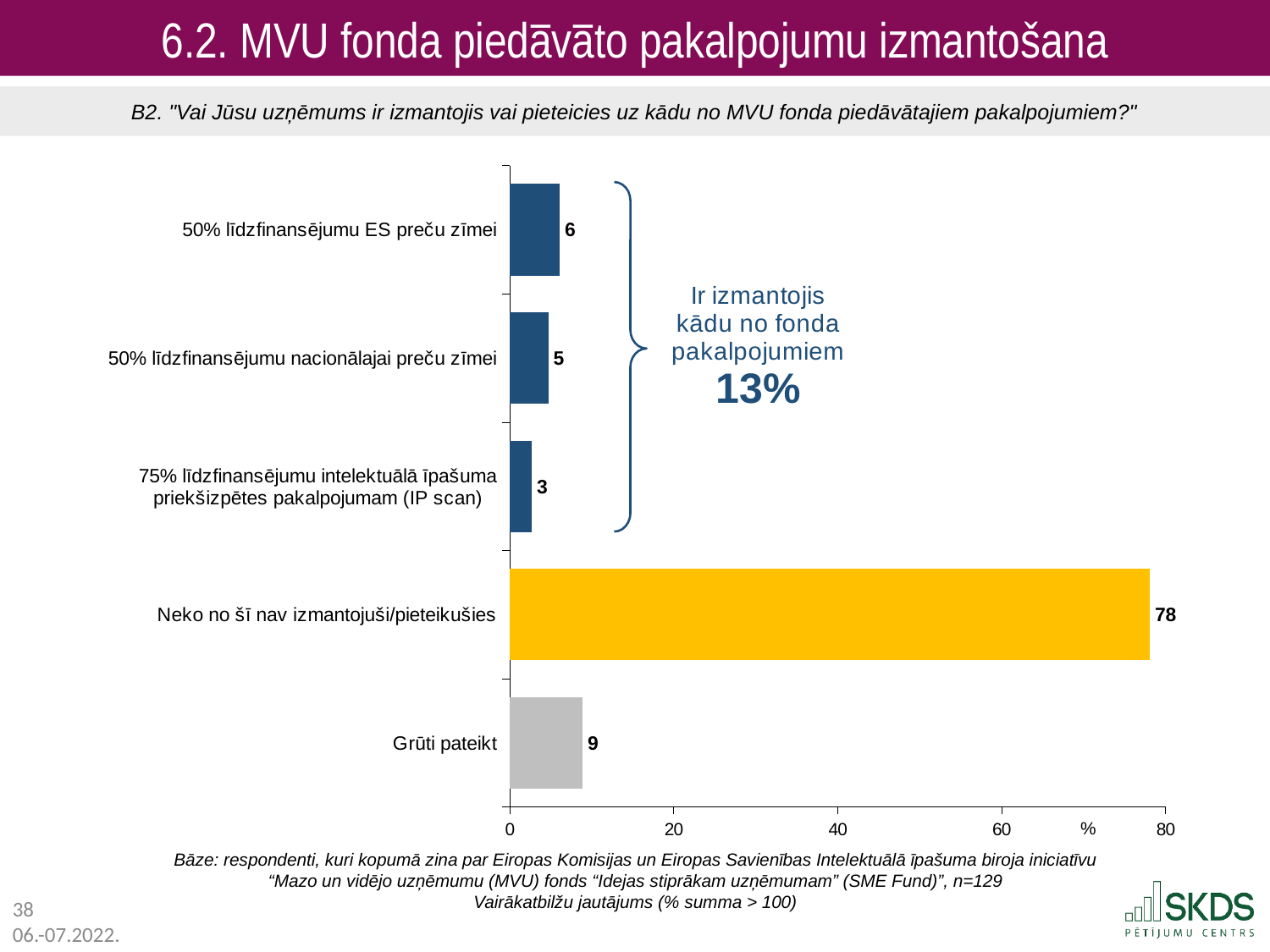
What is the difference between the values for "Neko no šī nav izmantojuši/pieteikušies" and "Grūti pateikt"? 69 What is the value for "Neko no šī nav izmantojuši/pieteikušies"? 78 What is the value for "75% līdzfinansējumu intelektuālā īpašuma priekšizpētes pakalpojumam (IP scan)"? 3 What kind of chart is shown on the slide? bar chart What is the value for "Grūti pateikt"? 9 What percentage is shown next to the bracket labelled "Ir izmantojis kādu no fonda pakalpojumiem"? 13% Is the value for "Neko no šī nav izmantojuši/pieteikušies" greater or less than 60? greater How many categories are shown in the chart? 5 Which category has the highest value? Neko no šī nav izmantojuši/pieteikušies What is the value for "50% līdzfinansējumu ES preču zīmei"? 6 Which is larger: the value for "50% līdzfinansējumu ES preču zīmei" or for "50% līdzfinansējumu nacionālajai preču zīmei"? 50% līdzfinansējumu ES preču zīmei Which category has the lowest value? 75% līdzfinansējumu intelektuālā īpašuma priekšizpētes pakalpojumam (IP scan)